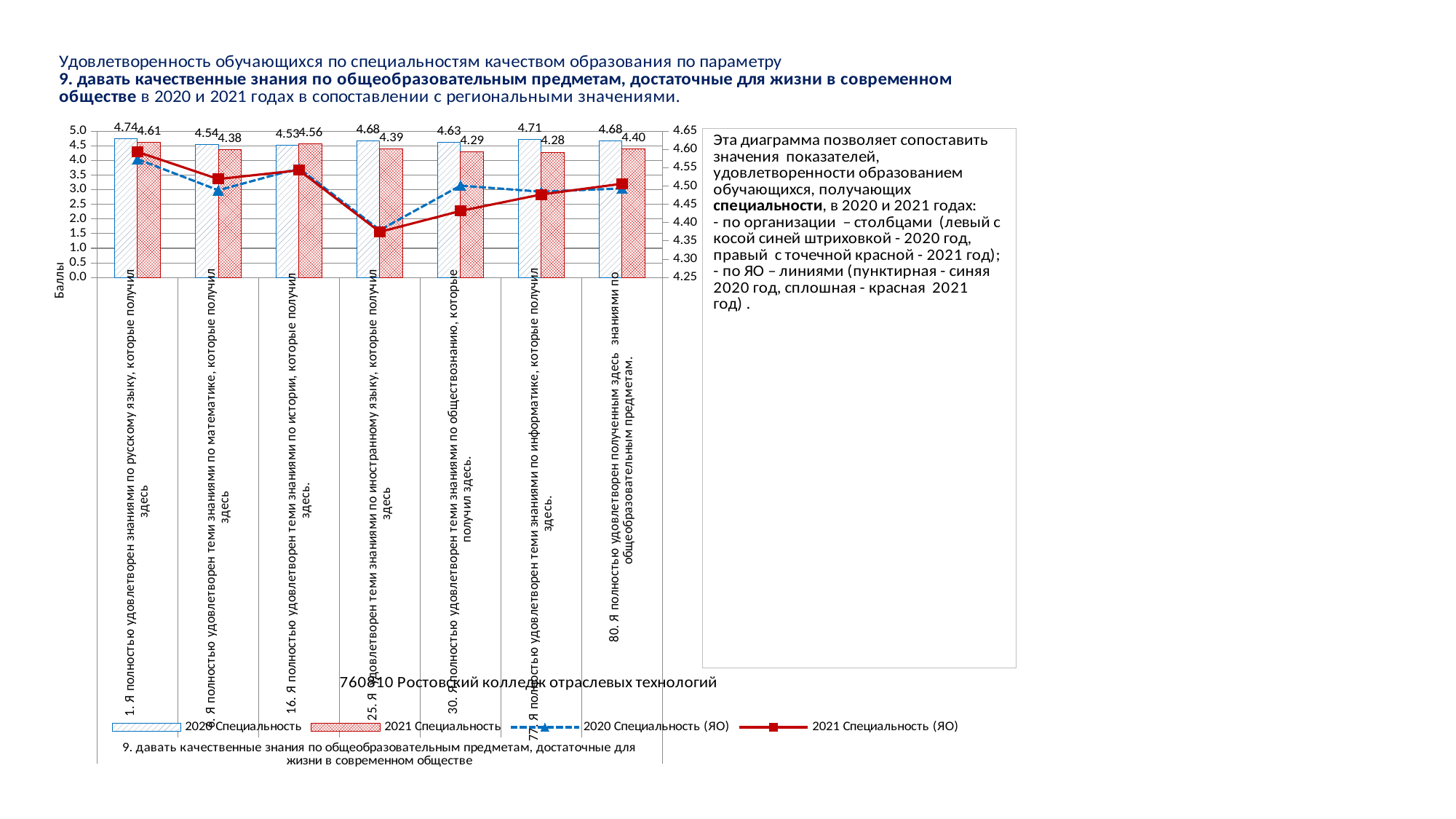
What is the value of the 2020 Специальность bar for category 1 (русскому языку)? 4.74 What kind of chart is shown on the slide? Combined bar and line chart Is the 2021 Специальность (ЯО) line value for category 1 (русскому языку) greater or less than 4.50 on the right axis? greater How many categories are shown on the x axis of the chart? 7 Which category has the highest 2021 Специальность bar? 1. Я полностью удовлетворен знаниями по русскому языку, которые получил здесь How many series does the chart legend list? 4 Which category has the lowest 2020 Специальность bar? 16. Я полностью удовлетворен теми знаниями по истории, которые получил здесь. Which category has the highest 2020 Специальность bar? 1. Я полностью удовлетворен знаниями по русскому языку, которые получил здесь What is the value of the 2021 Специальность bar for category 77 (информатике)? 4.28 What is the difference between the 2020 and 2021 Специальность bars for category 77 (информатике)? 0.43 What is the value of the 2021 Специальность bar for category 16 (истории)? 4.56 For category 16 (истории), which bar is larger: 2020 Специальность or 2021 Специальность? 2021 Специальность